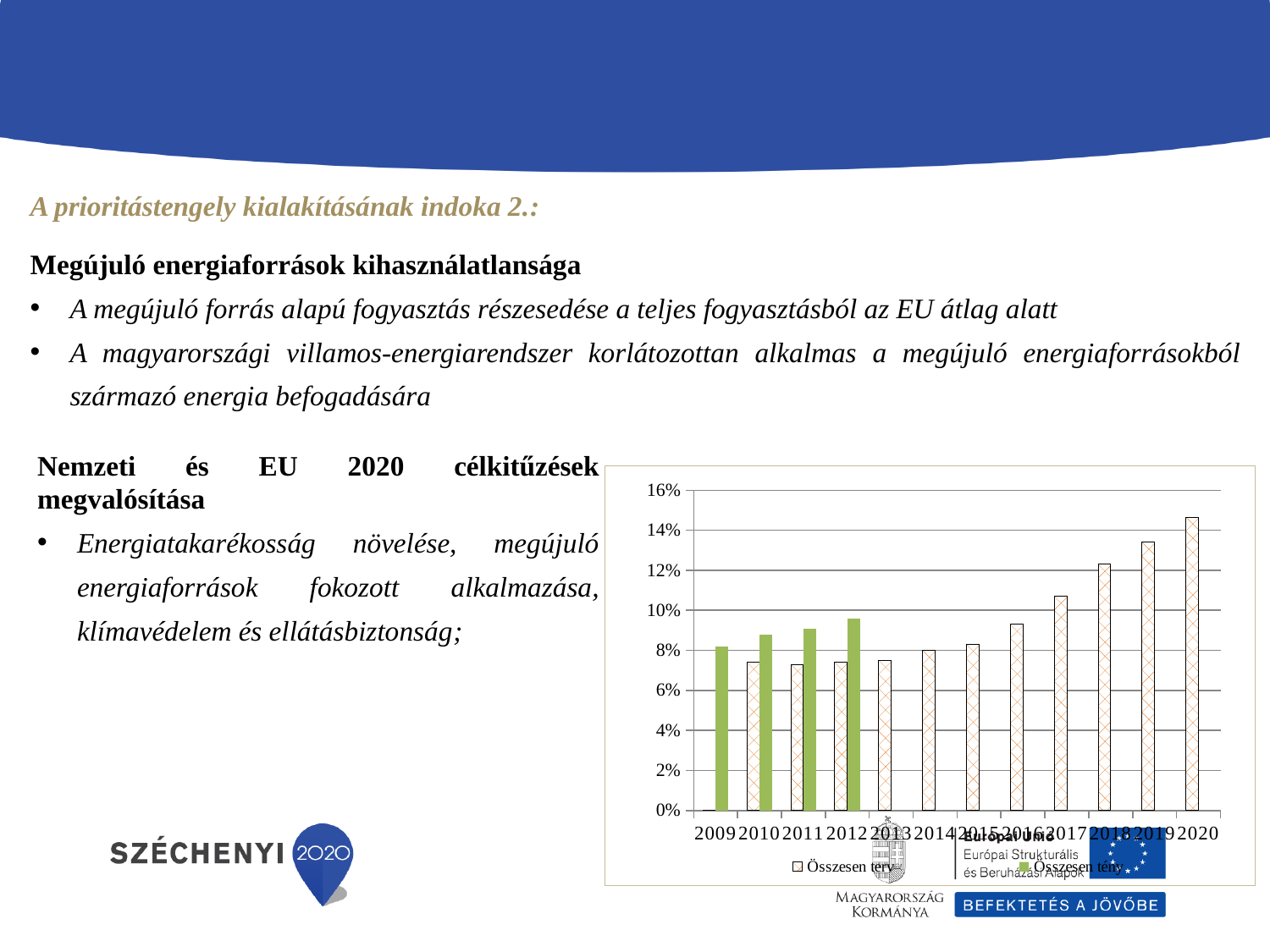
Do the Összesen terv values rise or fall from 2013 to 2020? rise Is the Összesen terv value for 2020 greater or less than 14%? greater Which year has the highest value for the Összesen tény series? 2012 Which year has the highest value for the Összesen terv series? 2020 Is the Összesen terv value for 2013 greater or less than 8%? less Is the Összesen tény value for 2012 greater or less than 10%? less What kind of chart is shown on the slide? bar chart How many years are shown on the x axis of the chart? 12 What are the two legend entries of the chart? Összesen terv and Összesen tény In 2012, which series has the larger value, Összesen terv or Összesen tény? Összesen tény How many series does the chart's legend list? 2